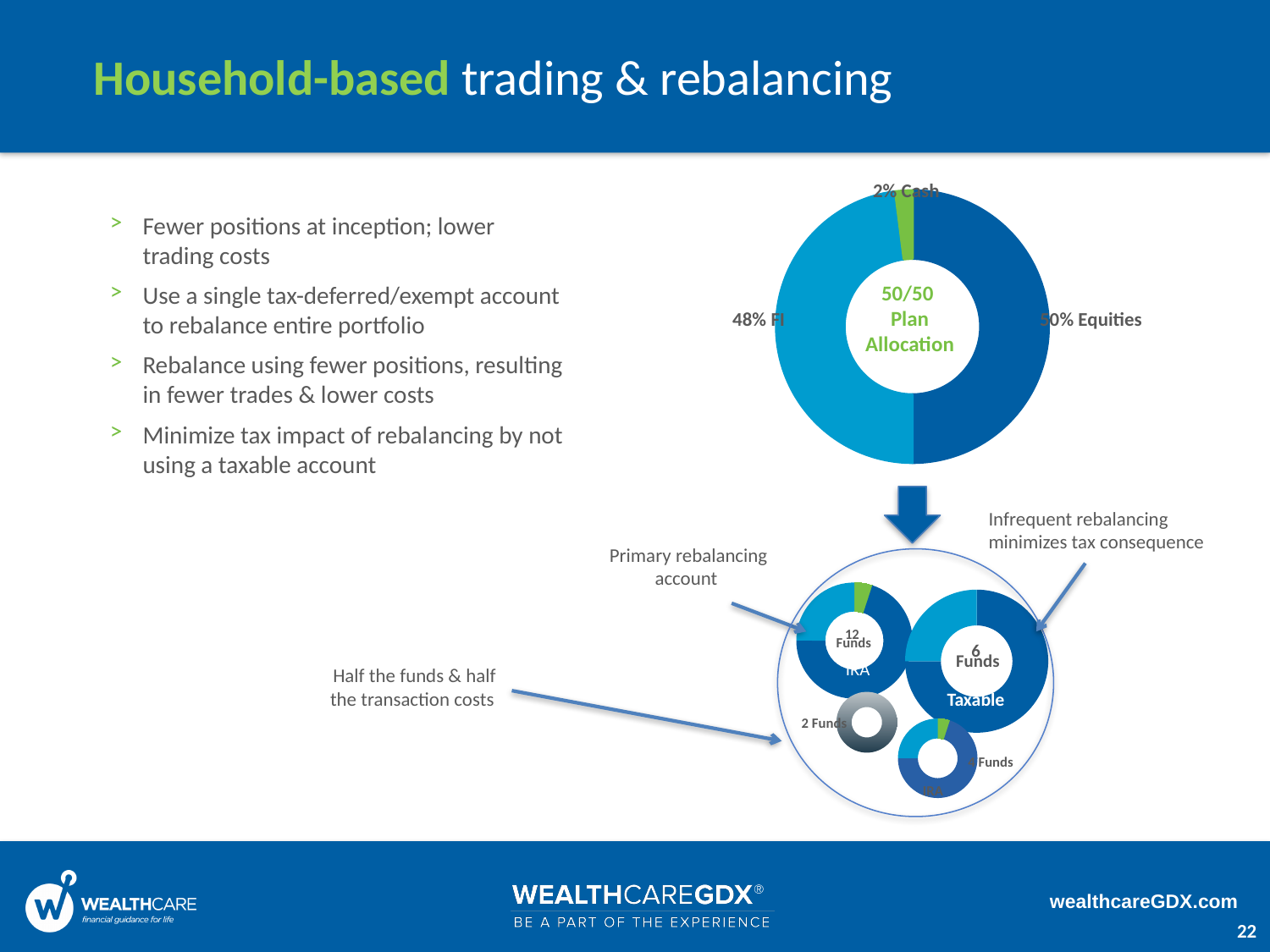
In the cluster of small donut charts at the bottom right, how many funds are shown for the IRA labelled as the primary rebalancing account? 12 Funds In the cluster of small donut charts at the bottom right, how many funds are shown for the Taxable account? 6 Funds In the main donut chart at the top right, which category has the largest share? Equities In the main donut chart at the top right, which category has the smallest share? Cash In the main donut chart at the top right, what is the difference in percentage points between the Equities share and the FI share? 2 How many categories are labelled in the main donut chart at the top right? 3 What text appears in the centre of the main donut chart at the top right? 50/50 Plan Allocation In the main donut chart at the top right, what share is labelled for Cash? 2% What kind of chart is the large chart at the top right of the slide? Donut (pie) chart In the main donut chart at the top right, what share is labelled for Equities? 50% In the main donut chart at the top right, what share is labelled for FI? 48% In the main donut chart at the top right, which is larger, the FI share or the Cash share? FI